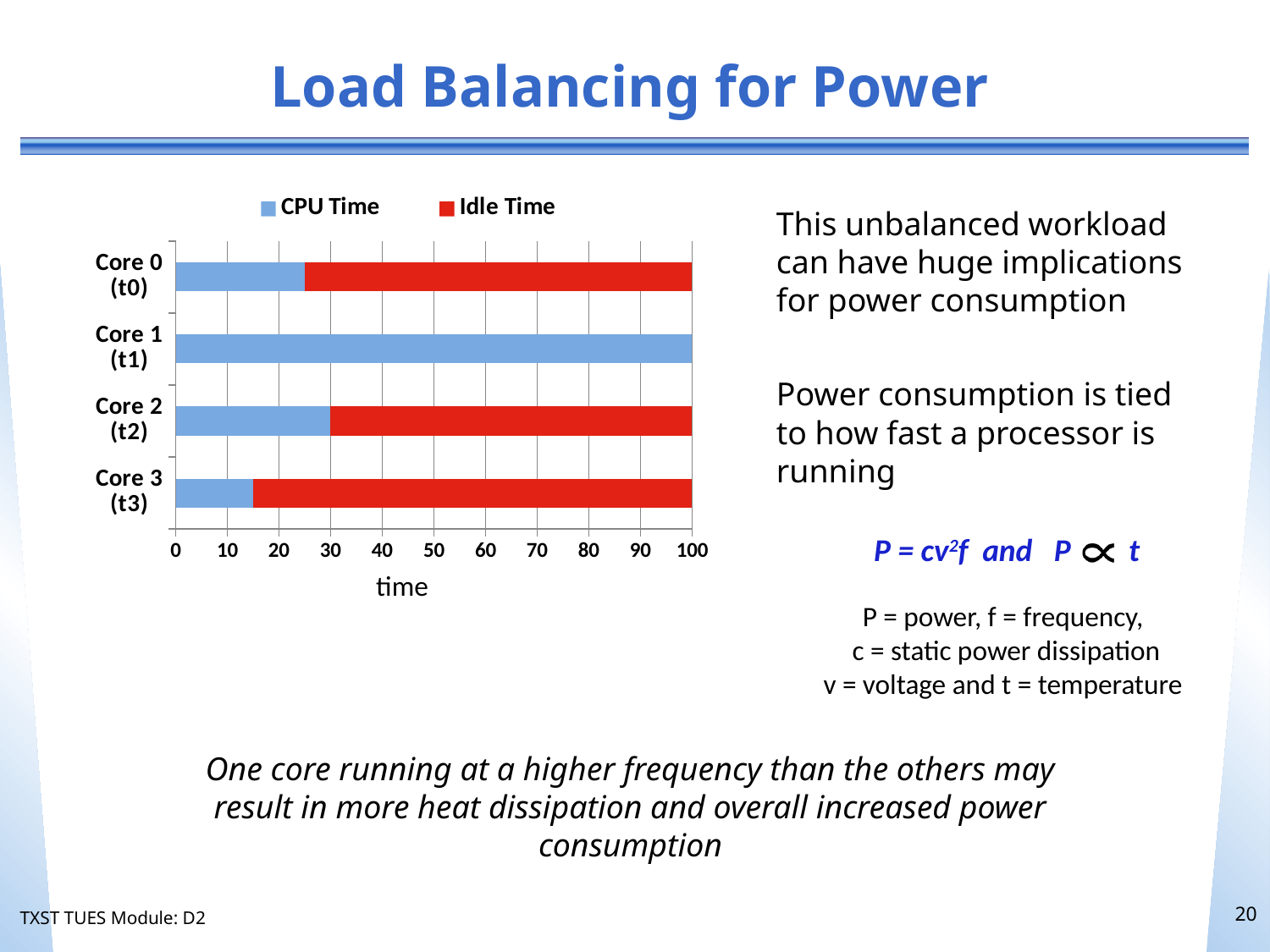
How many cores (categories) are plotted in the chart? 4 Which has the larger CPU Time, Core 0 (t0) or Core 2 (t2)? Core 2 (t2) What is the total length (CPU Time plus Idle Time) of the stacked bar for Core 0 (t0)? 100 Which core has the lowest CPU Time? Core 3 (t3) What is the CPU Time value for Core 2 (t2)? 30 What kind of chart is shown on the slide? bar chart What is the title of the x axis of the chart? time What is the CPU Time value for Core 1 (t1)? 100 Is the CPU Time value for Core 3 (t3) greater or less than 20? less How many series does the legend list? 2 Which core has the highest CPU Time? Core 1 (t1) Is the CPU Time value for Core 0 (t0) greater or less than 30? less